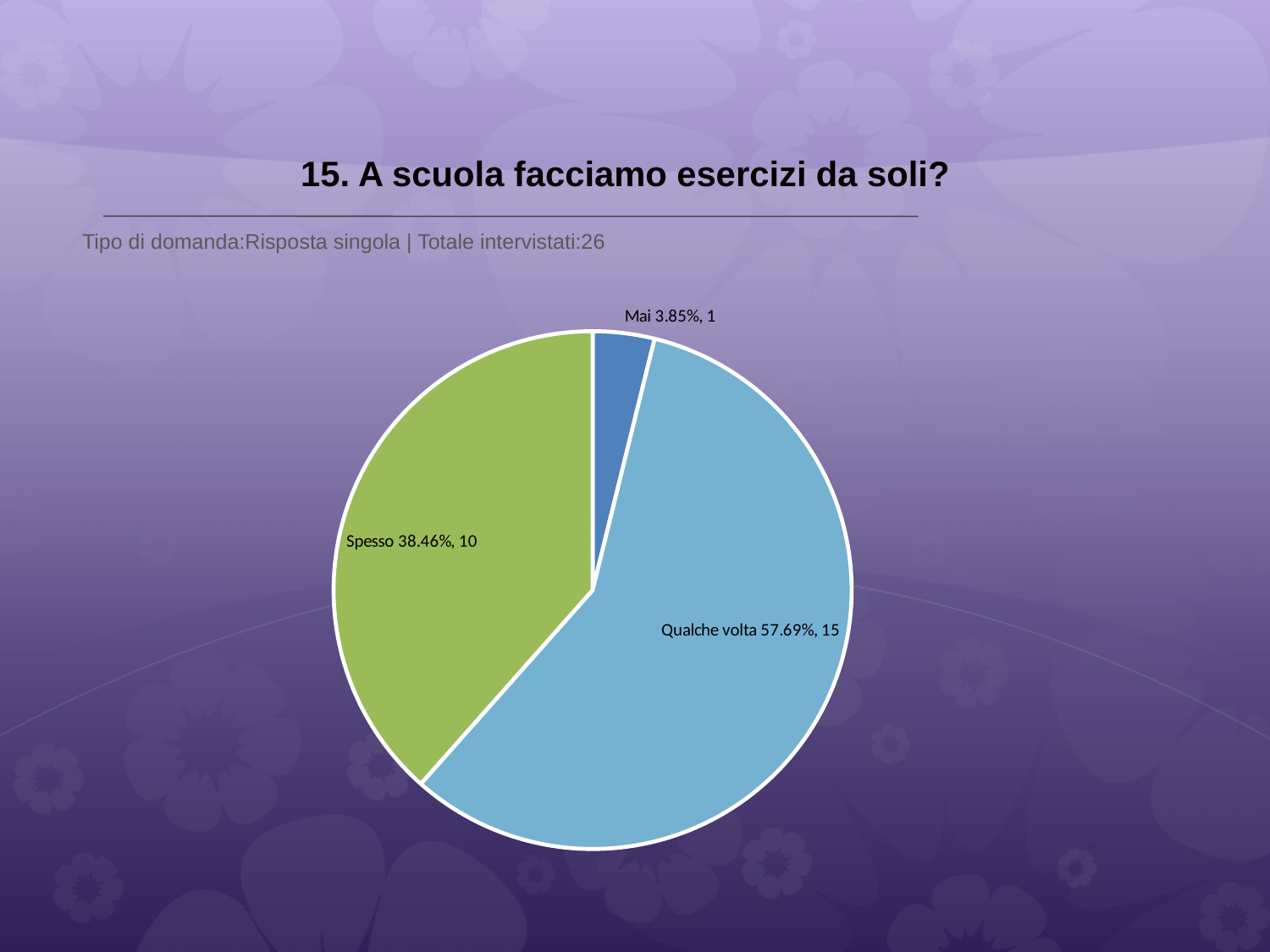
Which category has the largest slice? Qualche volta Which category has the smallest slice? Mai How many respondents answered 'Mai'? 1 What percentage share does the 'Spesso' slice have? 38.46% How many respondents answered 'Qualche volta'? 15 How many respondents answered 'Spesso'? 10 How many slices does the pie chart have? 3 What percentage share does the 'Mai' slice have? 3.85% What is the difference in respondent count between 'Qualche volta' and 'Spesso'? 5 What percentage share does the 'Qualche volta' slice have? 57.69% What is the title of the chart's question on the slide? 15. A scuola facciamo esercizi da soli? What kind of chart is shown on the slide? pie chart